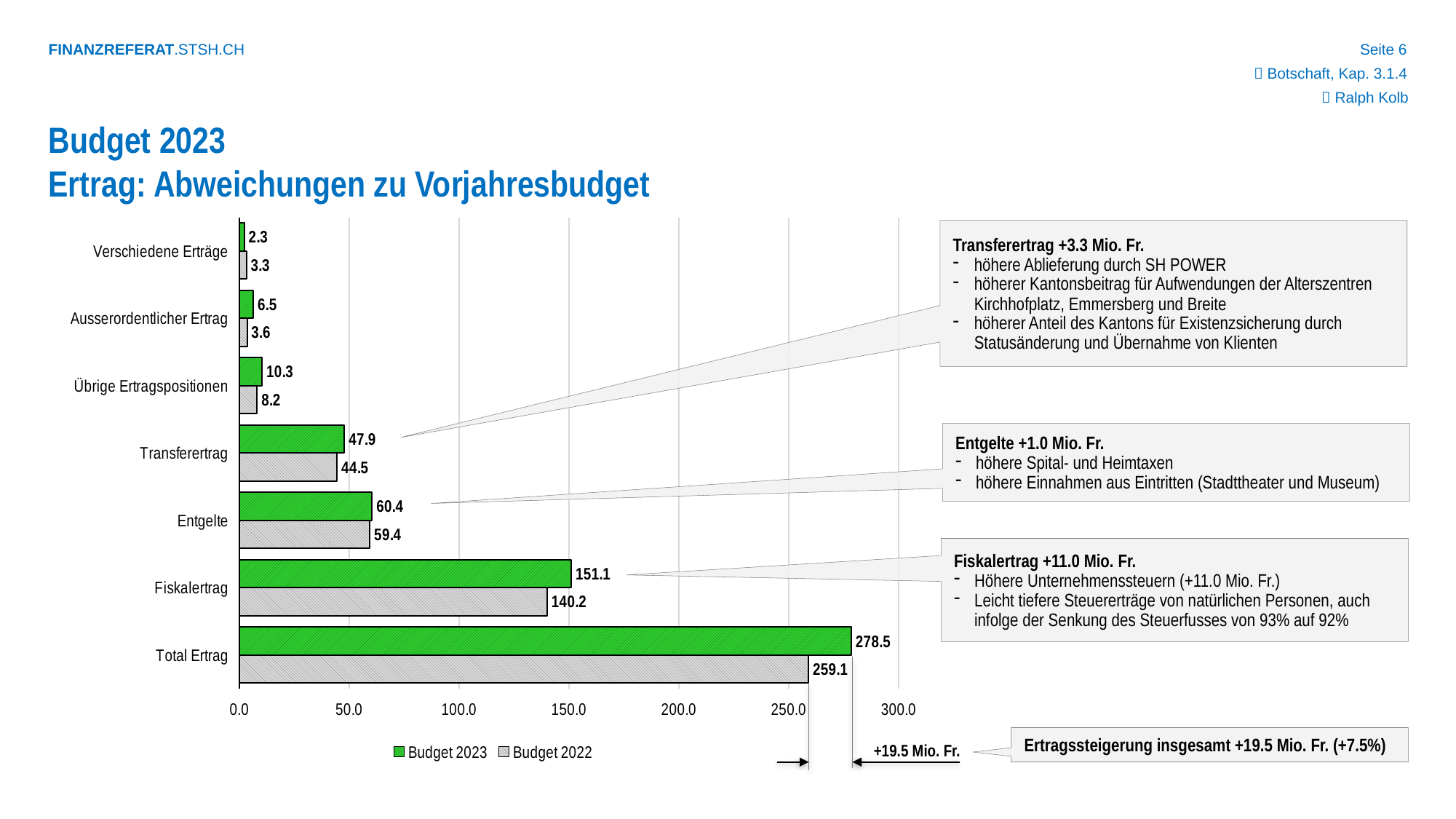
Which is larger for Verschiedene Erträge: Budget 2023 or Budget 2022? Budget 2022 Is the Budget 2022 value for Total Ertrag greater or less than 250.0? greater What is the Budget 2022 value for Entgelte? 59.4 Which category has the highest Budget 2023 value? Total Ertrag What is the Budget 2023 value for Fiskalertrag? 151.1 What is the difference between the Budget 2023 and Budget 2022 values for Total Ertrag? 19.4 How many series does the legend list? 2 What is the Budget 2023 value for Transferertrag? 47.9 What is the difference between the Budget 2023 and Budget 2022 values for Fiskalertrag? 10.9 What kind of chart is shown on the slide? Bar chart Which category has the lowest Budget 2023 value? Verschiedene Erträge How many categories are shown on the y axis of the chart? 7